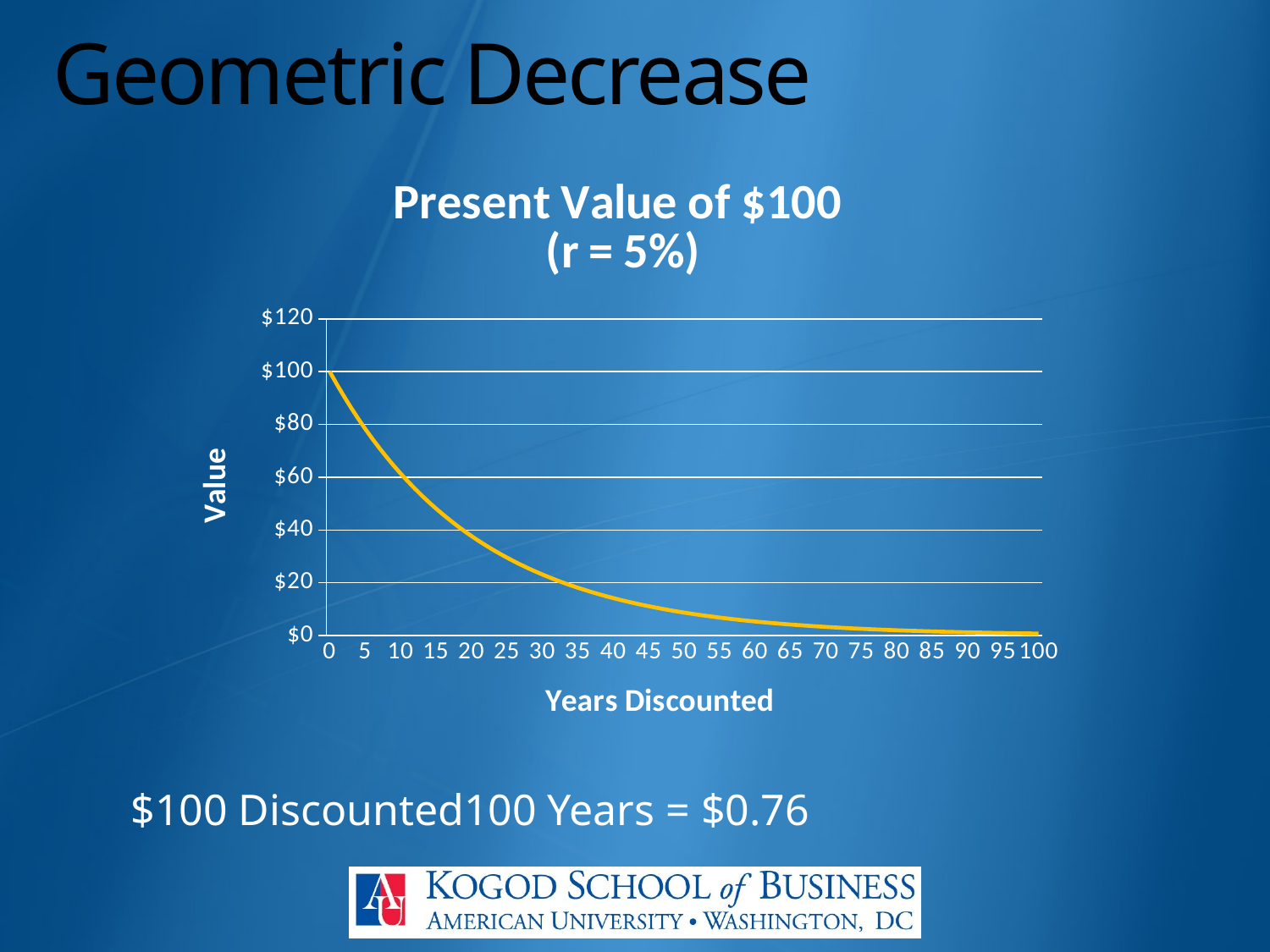
At which number of years discounted is the value lowest? 100 At which number of years discounted is the value highest? 0 Is the value at 15 years discounted greater or less than $60? less Do the values rise or fall as the years discounted increase? fall What kind of chart is shown on the slide? line chart Which is larger, the value at 10 years discounted or the value at 50 years discounted? 10 years discounted What is the title of the chart? Present Value of $100 (r = 5%) What is the label of the x axis? Years Discounted What is the value of $100 discounted 100 years? $0.76 Is the value at 5 years discounted greater or less than $60? greater Is the value at 40 years discounted greater or less than $20? less What is the value at 0 years discounted? $100